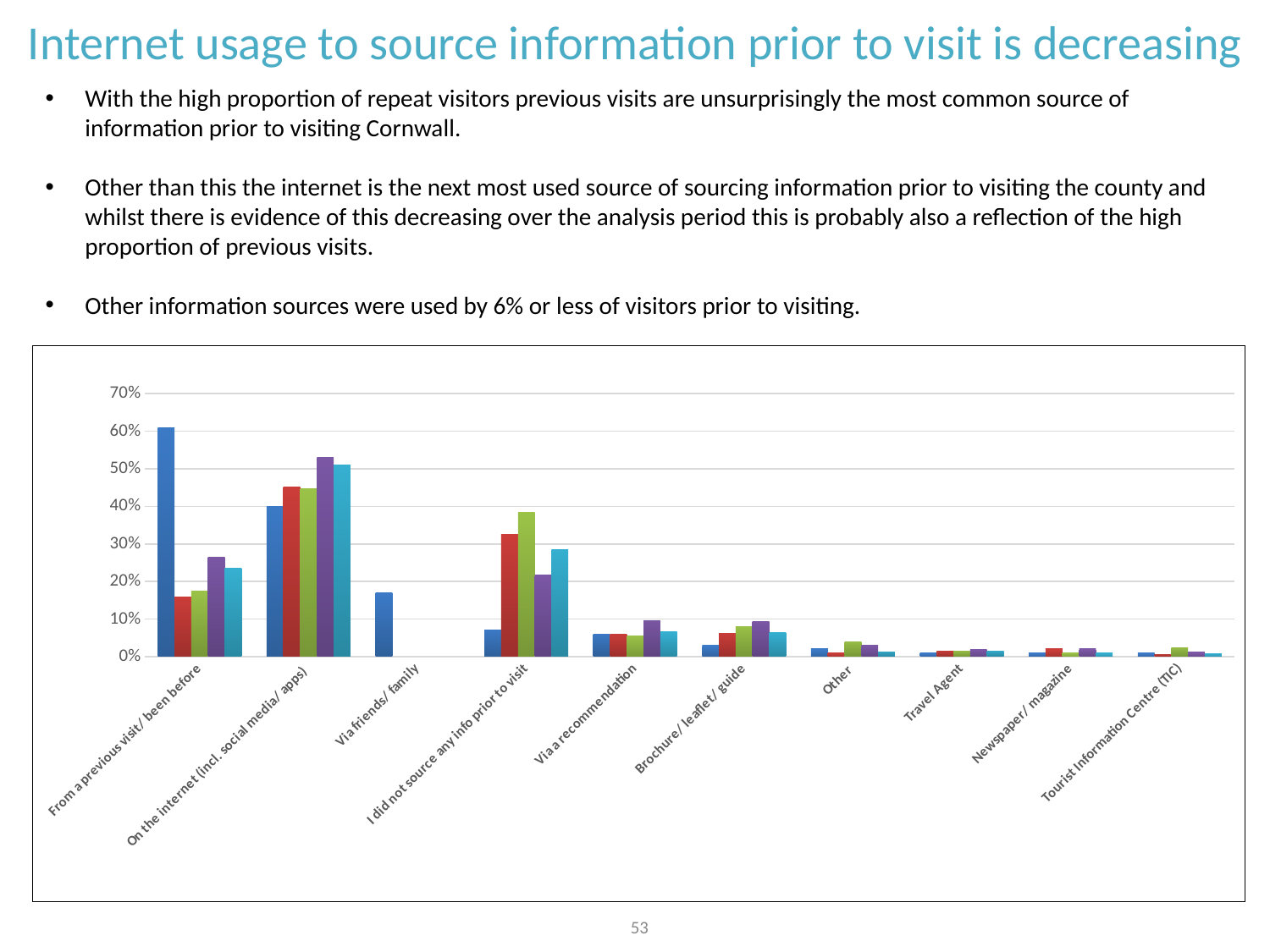
Which category has the tallest bar in the chart? From a previous visit/ been before Which is larger: the blue bar for 'From a previous visit/ been before' or the blue bar for 'On the internet (incl. social media/ apps)'? From a previous visit/ been before Is the value of the blue bar for 'Via friends/ family' greater or less than 10%? greater Is the value of the tallest (blue) bar for 'From a previous visit/ been before' greater or less than 50%? greater How many categories are shown along the x axis of the chart? 10 What is the highest value shown on the chart's y axis? 70% Is the value of the blue bar for 'I did not source any info prior to visit' greater or less than 10%? less Which is larger: the red bar for 'On the internet (incl. social media/ apps)' or the red bar for 'From a previous visit/ been before'? On the internet (incl. social media/ apps) What kind of chart is shown on the slide? bar chart